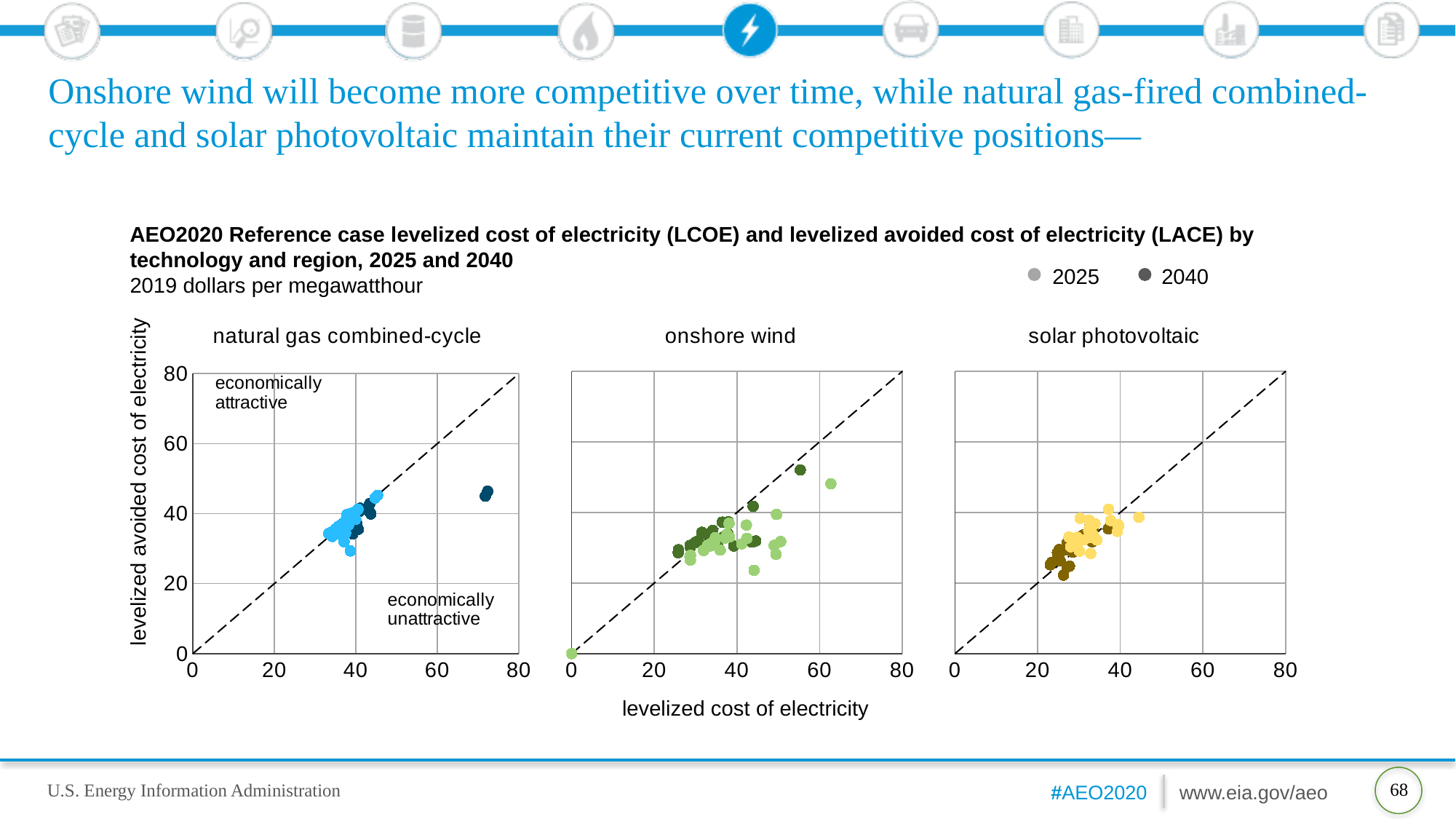
In the onshore wind chart, is the levelized cost of electricity of the rightmost point greater or less than 40? greater In the natural gas combined-cycle chart, is the levelized cost of electricity of the isolated outlier point on the right greater or less than 60? greater In the natural gas combined-cycle chart, is the levelized avoided cost of electricity of the highest point greater or less than 60? less Which two years are listed in the legend? 2025 and 2040 What kind of chart is used in each of the three panels on the slide? scatter chart What is the label of the shared x axis? levelized cost of electricity How many series does the legend list? 2 How many technology panels (charts) are shown on the slide? 3